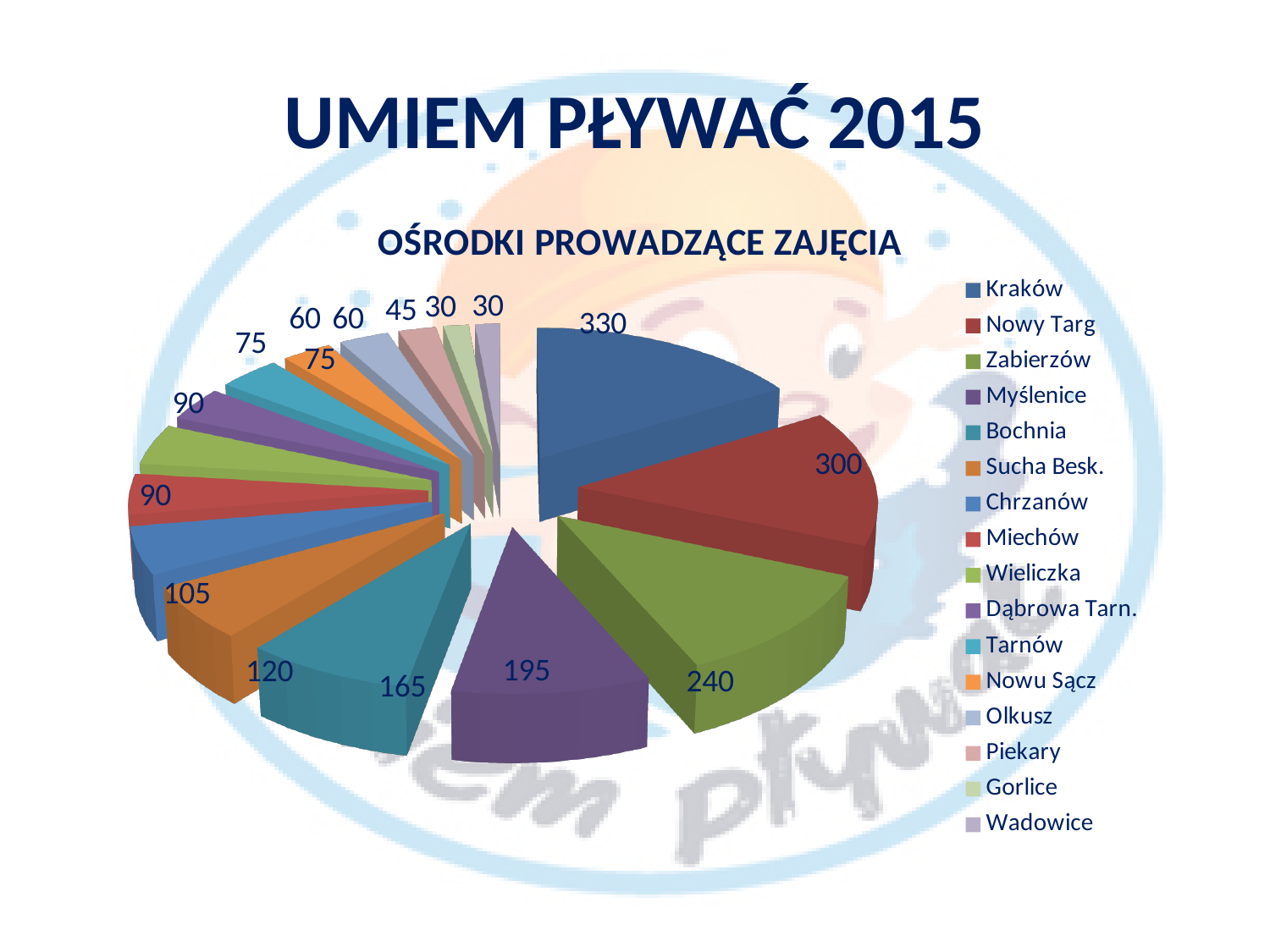
What is the value for Nowy Targ? 300 What is the value for Chrzanów? 105 What is the difference between the values for Kraków and Zabierzów? 90 What is the value for Kraków? 330 What is the value for Piekary? 45 What is the difference between the values for Myślenice and Sucha Besk.? 75 What is the value for Bochnia? 165 What type of chart is shown on the slide? pie chart Which is larger, the value for Nowy Targ or the value for Myślenice? Nowy Targ What is the title of the chart? OŚRODKI PROWADZĄCE ZAJĘCIA How many centres are listed in the legend? 16 Which centre has the highest value? Kraków